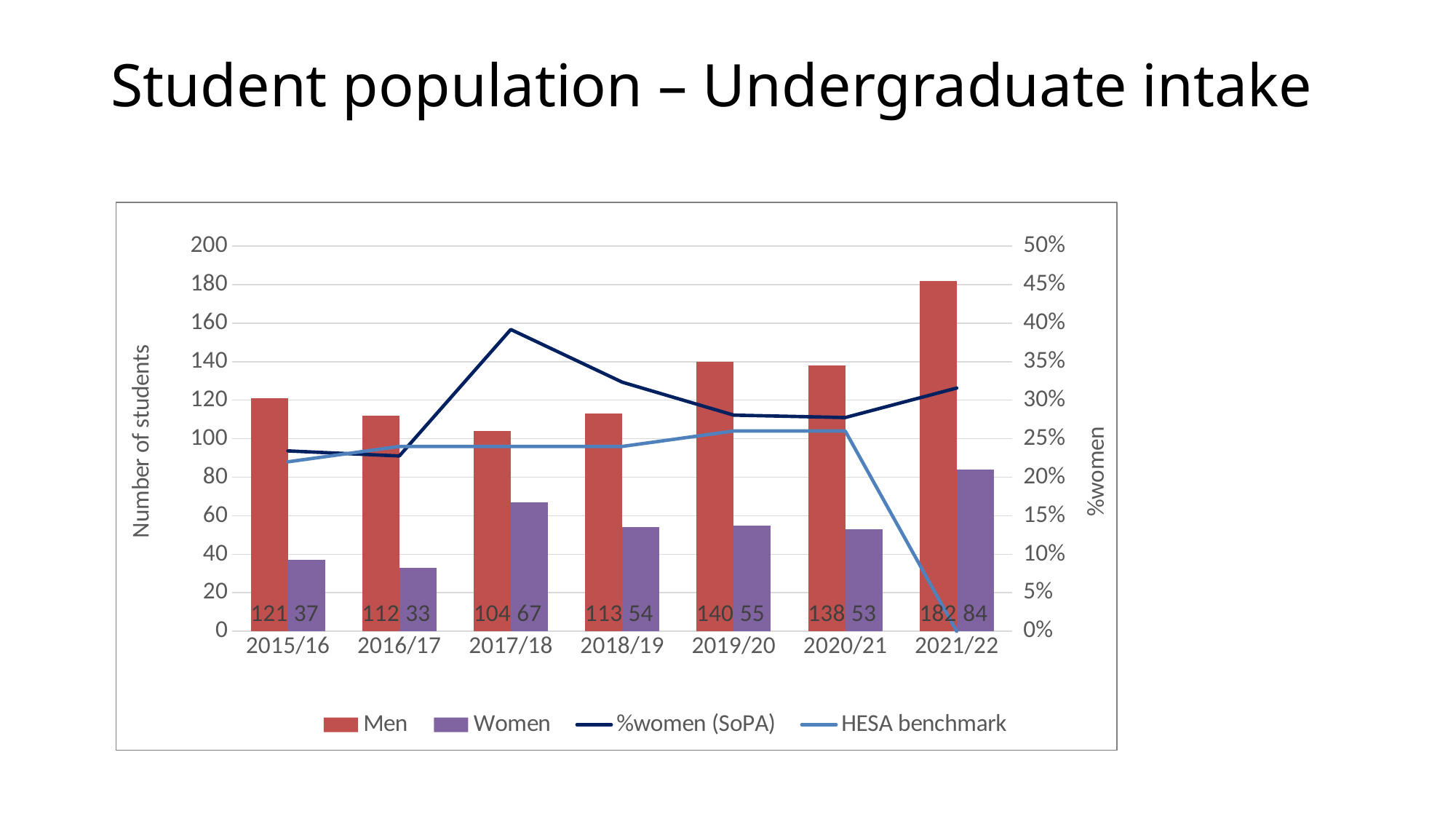
Which year has the larger Men value, 2015/16 or 2016/17? 2015/16 In which year is the Women value lowest? 2016/17 In which year is the Men value highest? 2021/22 What kind of chart is shown on the slide? Combined bar and line chart What is the value for Women in 2017/18? 67 How many series does the legend list? 4 Do the Men values rise or fall from 2017/18 to 2019/20? rise What is the value for Men in 2019/20? 140 Is the %women (SoPA) value for 2017/18 greater or less than 35%? greater What is the difference between the Men and Women values in 2021/22? 98 How many academic years are shown on the x axis? 7 What is the total number of Men and Women students in 2015/16? 158